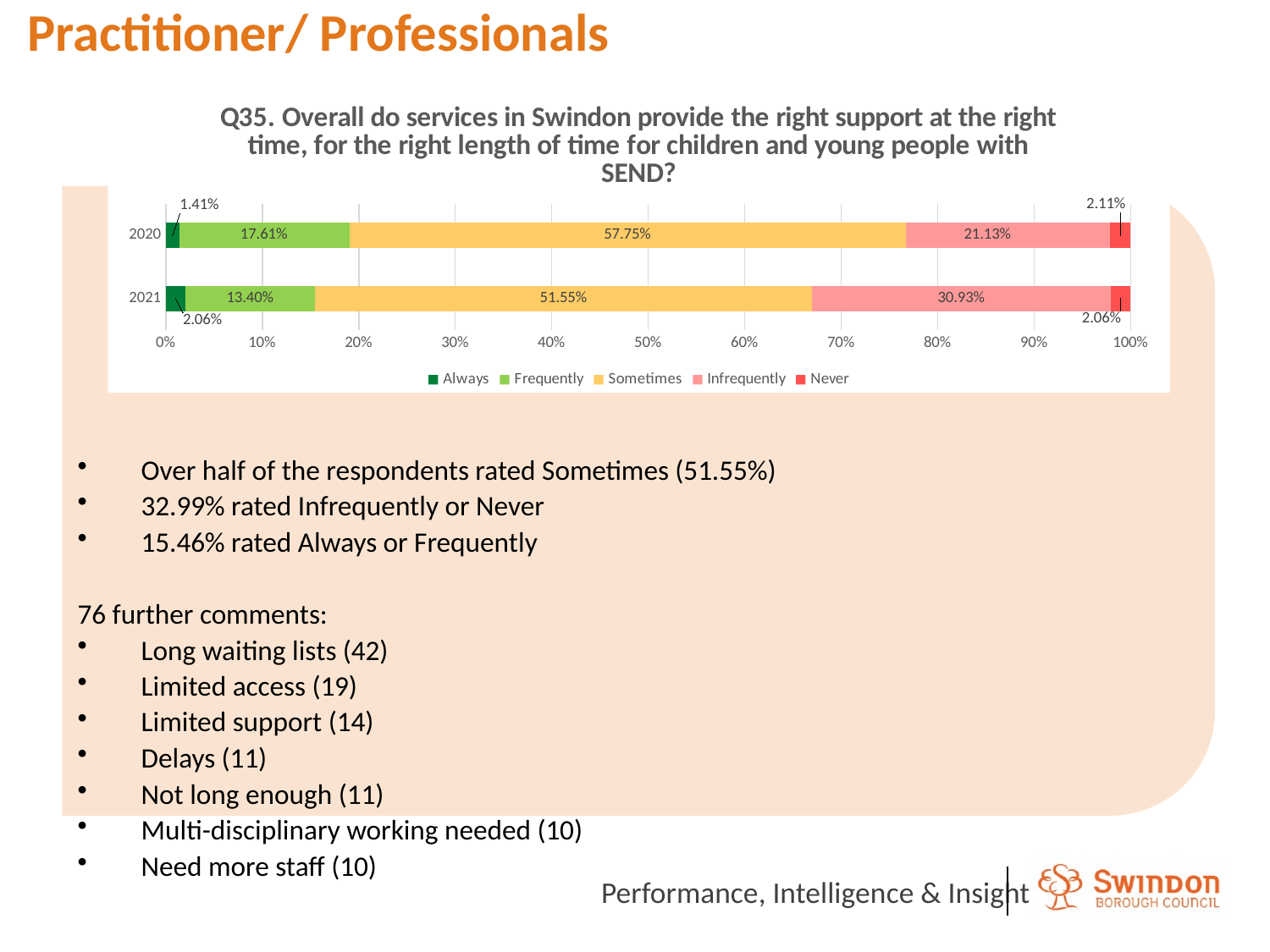
What percentage of respondents rated Frequently in 2020? 17.61% What percentage of respondents rated Always in 2021? 2.06% Which response category has the largest share in 2021? Sometimes What kind of chart is shown on the slide? Stacked bar chart What percentage of respondents rated Sometimes in 2020? 57.75% What percentage of respondents rated Never in 2020? 2.11% Which year had a larger share of Frequently responses, 2020 or 2021? 2020 What percentage of respondents rated Infrequently in 2021? 30.93% How many series does the legend list? 5 By how many percentage points did the Infrequently share change from 2020 to 2021? 9.80% Which response category has the smallest share in 2020? Always What percentage of respondents rated Sometimes in 2021? 51.55%